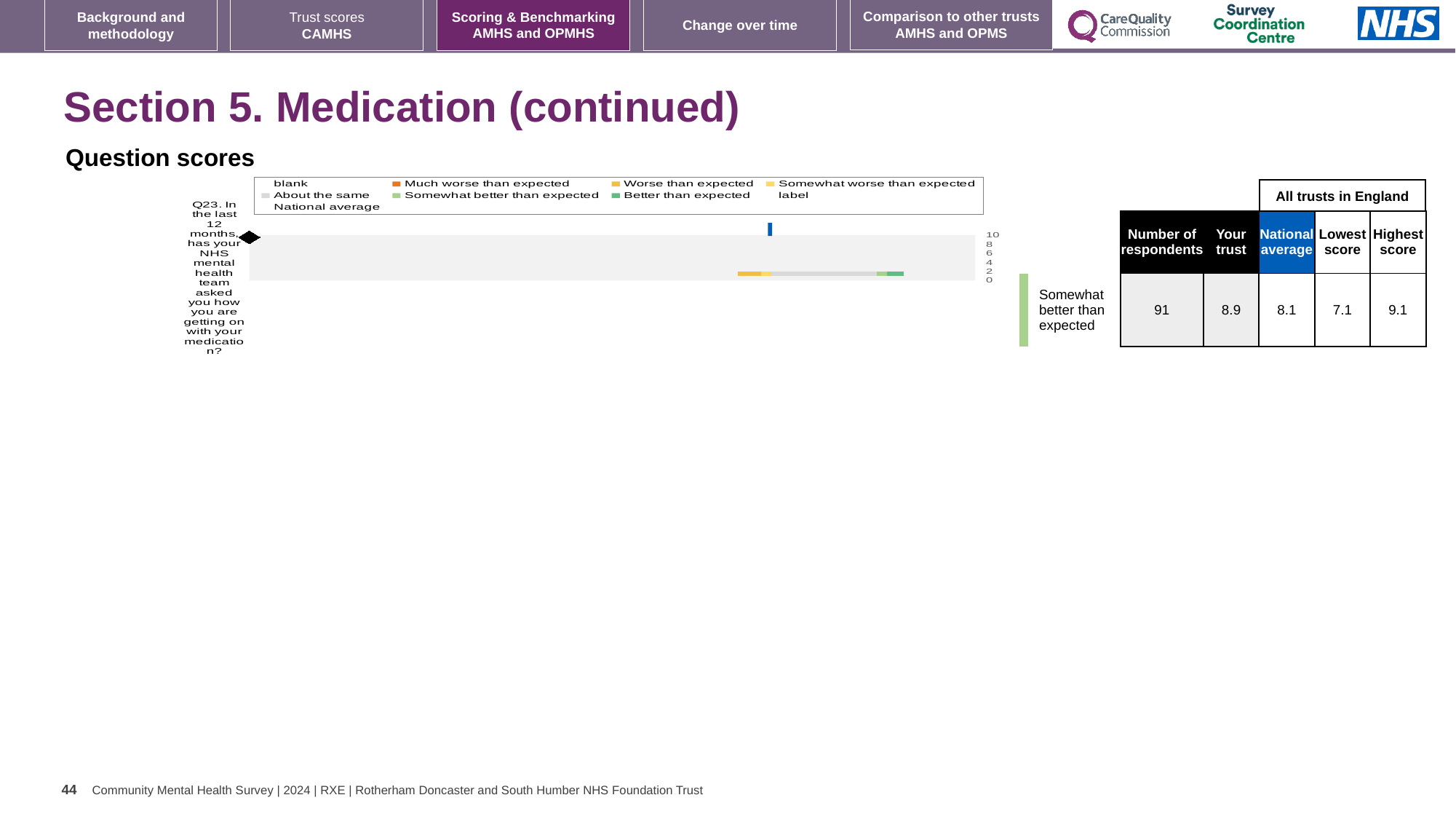
What rating label is shown to the right of the chart for Q23? Somewhat better than expected How many question categories are plotted in the chart? 1 In the table beside the chart, what is the 'Your trust' score for Q23? 8.9 Which question is plotted in the chart? Q23. In the last 12 months, has your NHS mental health team asked you how you are getting on with your medication? What colour does the legend use for 'Better than expected'? green In the table beside the chart, what is the highest score among all trusts in England for Q23? 9.1 What kind of chart is shown under 'Question scores'? bar chart In the table beside the chart, what is the number of respondents for Q23? 91 In the table beside the chart, what is the national average for Q23? 8.1 Which is larger for Q23, the 'Your trust' score or the national average? Your trust In the table beside the chart, what is the lowest score among all trusts in England for Q23? 7.1 What is the difference between the highest score and the lowest score for Q23? 2.0